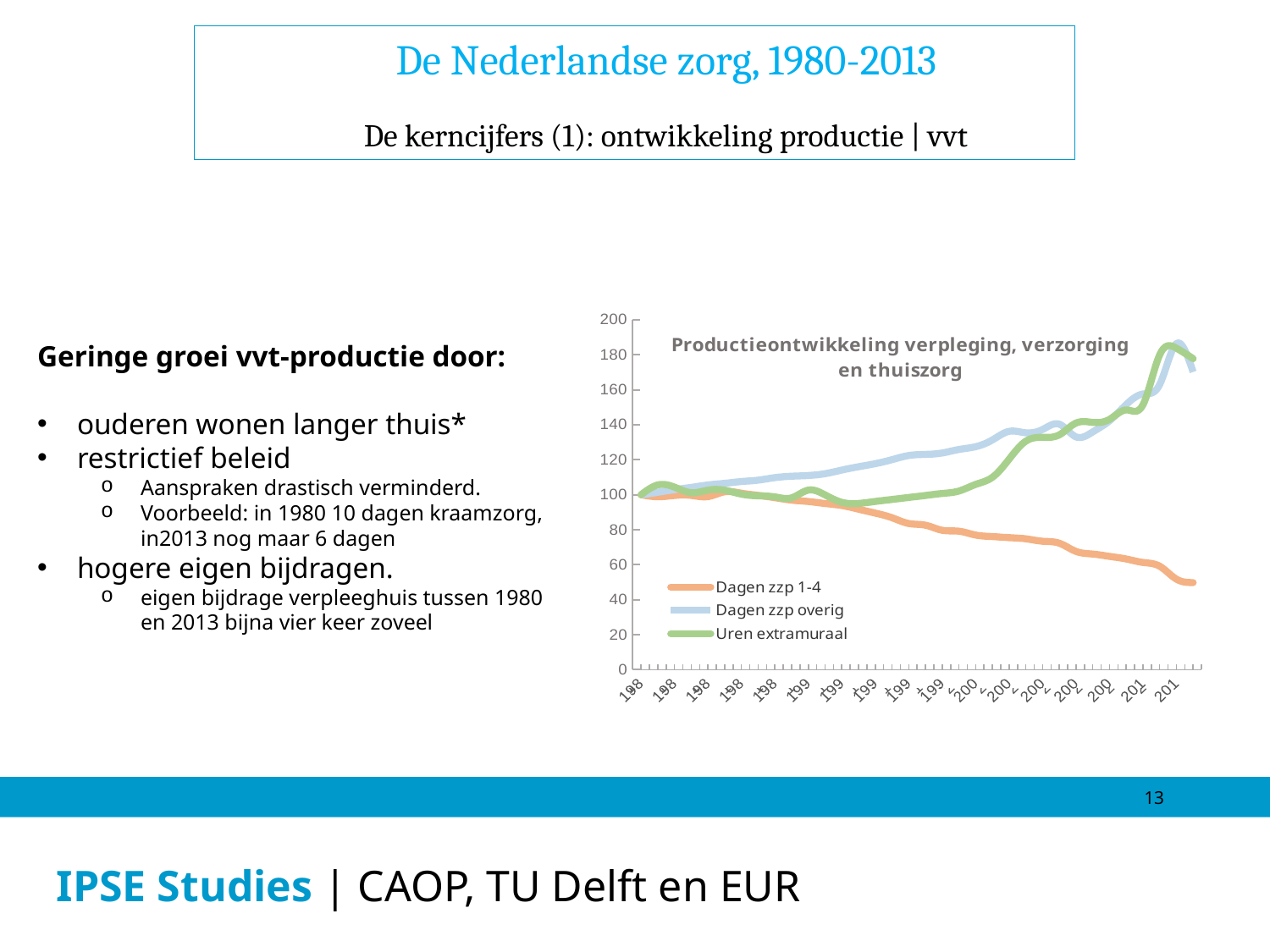
What is the title of the chart? Productieontwikkeling verpleging, verzorging en thuiszorg Is the final value of Dagen zzp 1-4 greater or less than 60? less Is the final value of Dagen zzp overig greater or less than 160? greater Does the series Dagen zzp overig rise or fall over the period shown? rise What kind of chart is shown on the slide? line chart At the end of the period, which is higher: Dagen zzp overig or Dagen zzp 1-4? Dagen zzp overig How many series does the chart's legend list? 3 Is the peak value of Uren extramuraal greater or less than 180? greater Does the series Dagen zzp 1-4 rise or fall over the period shown? fall At what value do all three series start at the left of the chart? 100 Which series is drawn in orange in the chart? Dagen zzp 1-4 Which series has the lowest value at the end of the period? Dagen zzp 1-4